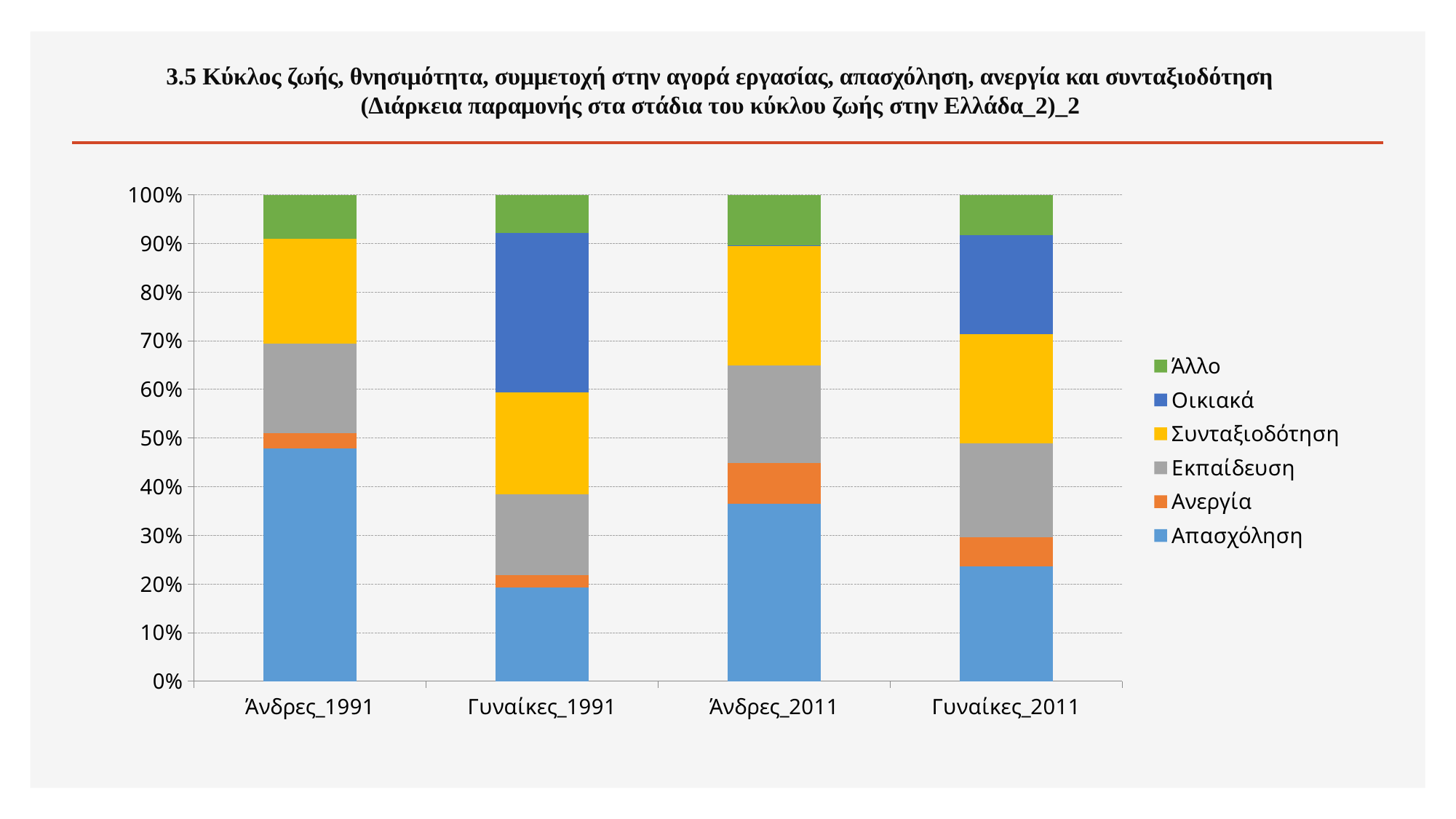
How many categories are shown on the x axis? 4 Which category has the largest Απασχόληση segment? Άνδρες_1991 How many series does the legend list? 6 What is the total height of the Άνδρες_1991 stacked bar? 100% Which category has the smallest Απασχόληση segment? Γυναίκες_1991 Which category has the largest Οικιακά segment? Γυναίκες_1991 Which is larger, the Απασχόληση segment for Άνδρες_1991 or for Άνδρες_2011? Άνδρες_1991 Is the Απασχόληση value for Γυναίκες_1991 greater or less than 30%? less Is the Απασχόληση value for Άνδρες_2011 greater or less than 30%? greater Which series is listed first (at the top) in the legend? Άλλο What kind of chart is shown on the slide? Stacked bar chart Is the Απασχόληση value for Άνδρες_1991 greater or less than 40%? greater